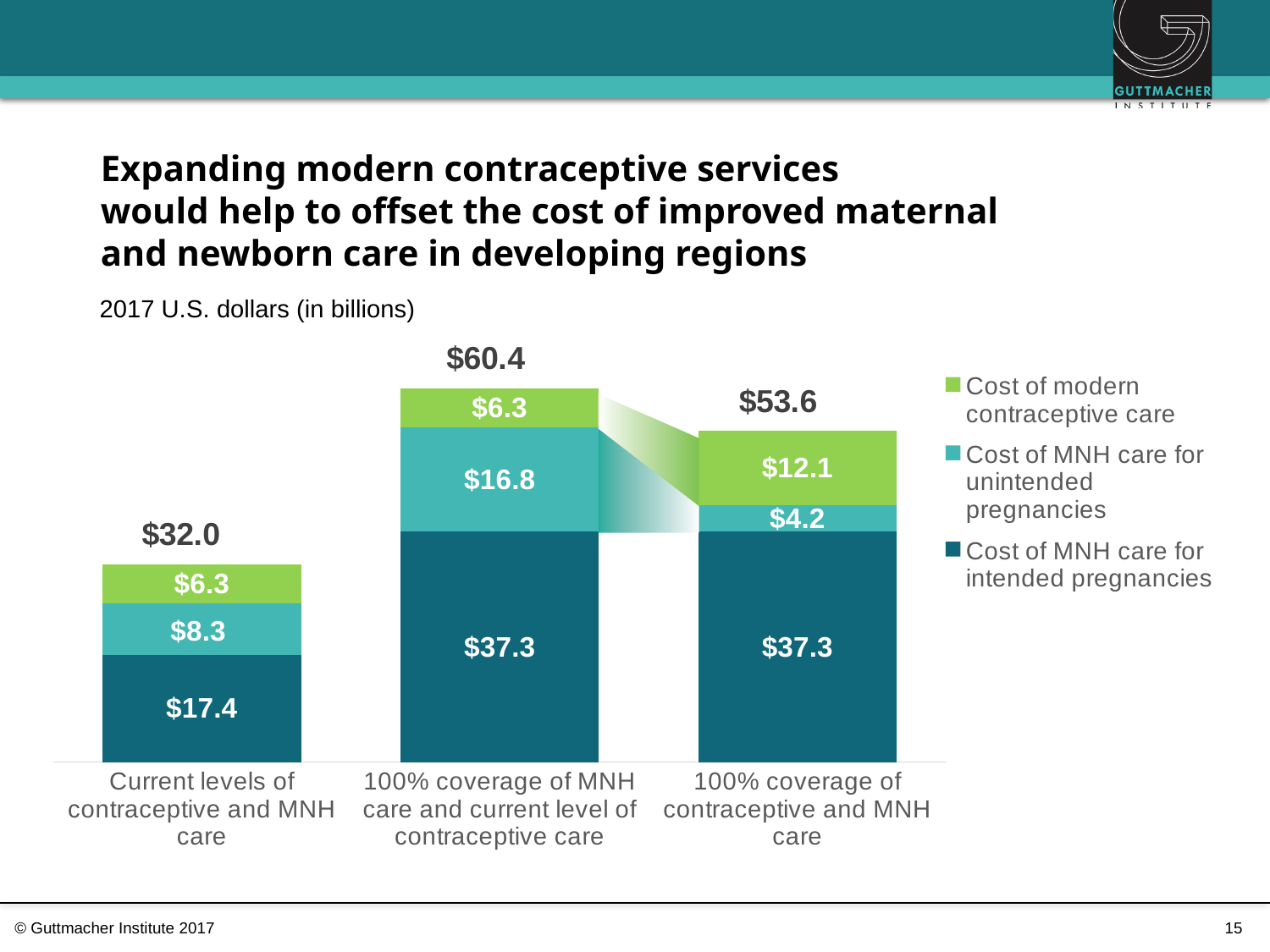
What is the cost of modern contraceptive care under 100% coverage of contraceptive and MNH care? $12.1 What is the cost of MNH care for unintended pregnancies under 100% coverage of MNH care and current level of contraceptive care? $16.8 What is the difference in total cost between the 100% coverage of MNH care and current level of contraceptive care scenario and the 100% coverage of contraceptive and MNH care scenario? $6.8 What kind of chart is shown on the slide? Stacked bar chart Which scenario has the highest total cost? 100% coverage of MNH care and current level of contraceptive care What is the cost of MNH care for intended pregnancies under current levels of contraceptive and MNH care? $17.4 How many series does the legend list? 3 In what units are the values on the chart expressed? 2017 U.S. dollars (in billions) Which is larger: the cost of MNH care for unintended pregnancies under current levels, or under 100% coverage of contraceptive and MNH care? Current levels of contraceptive and MNH care Which scenario has the lowest total cost? Current levels of contraceptive and MNH care What is the total cost for the scenario of 100% coverage of MNH care and current level of contraceptive care? $60.4 How many scenarios (bars) are shown in the chart? 3